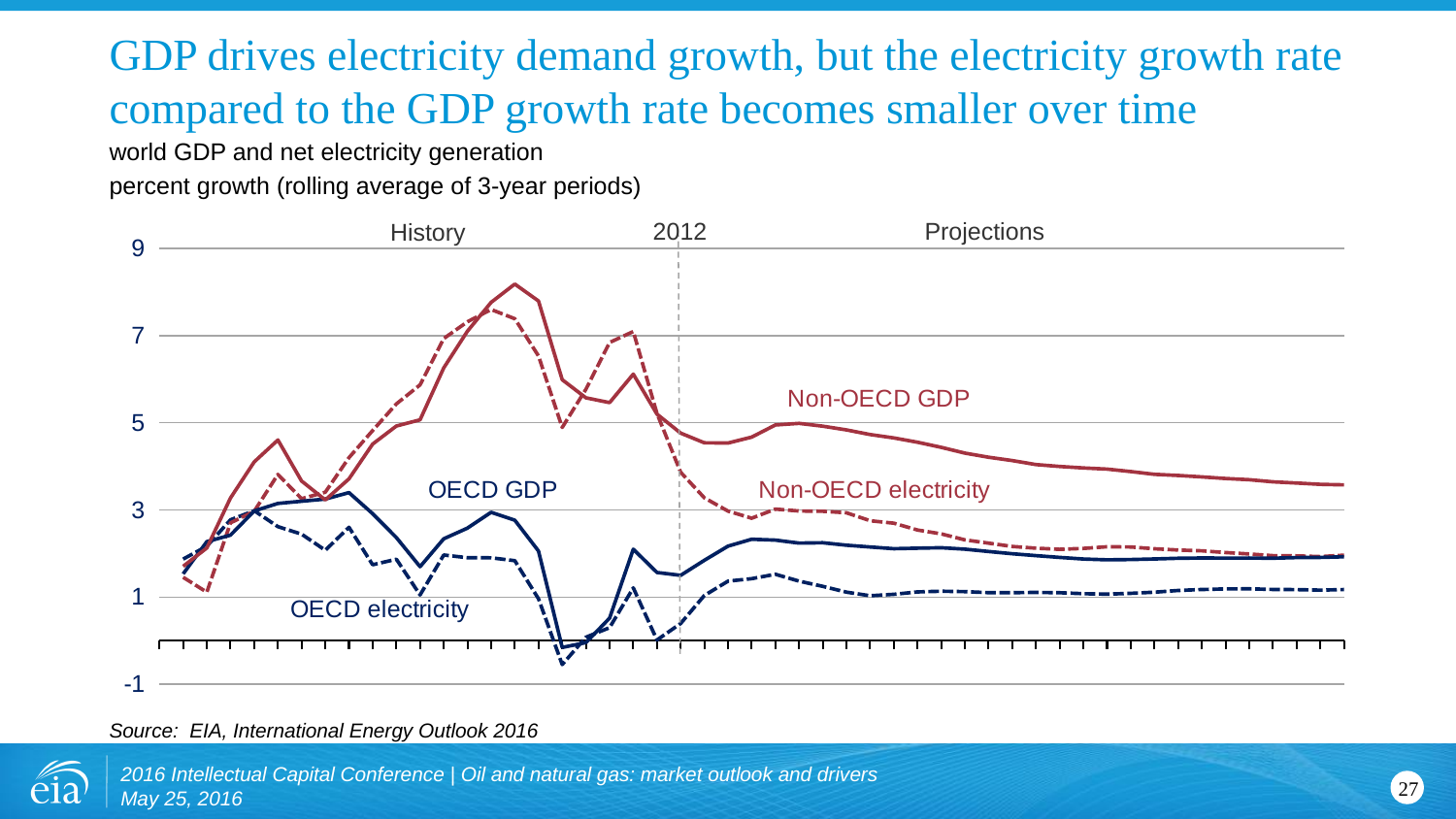
At the end of the projection period, is the value for OECD GDP greater or less than 3? less Which series reaches the highest peak on the chart? Non-OECD GDP What year does the vertical dashed line separating History and Projections mark? 2012 How many series are plotted on the chart? 4 At the end of the projection period, which is larger, Non-OECD GDP or OECD GDP? Non-OECD GDP What is the source cited for the chart? EIA, International Energy Outlook 2016 What kind of chart is shown on the slide? line chart Which series drops to the lowest value on the chart? OECD electricity At the end of the projection period, is the value for Non-OECD GDP greater or less than 3? greater Is the peak value of Non-OECD GDP greater or less than 7? greater Does Non-OECD GDP rise or fall over the projection period? fall